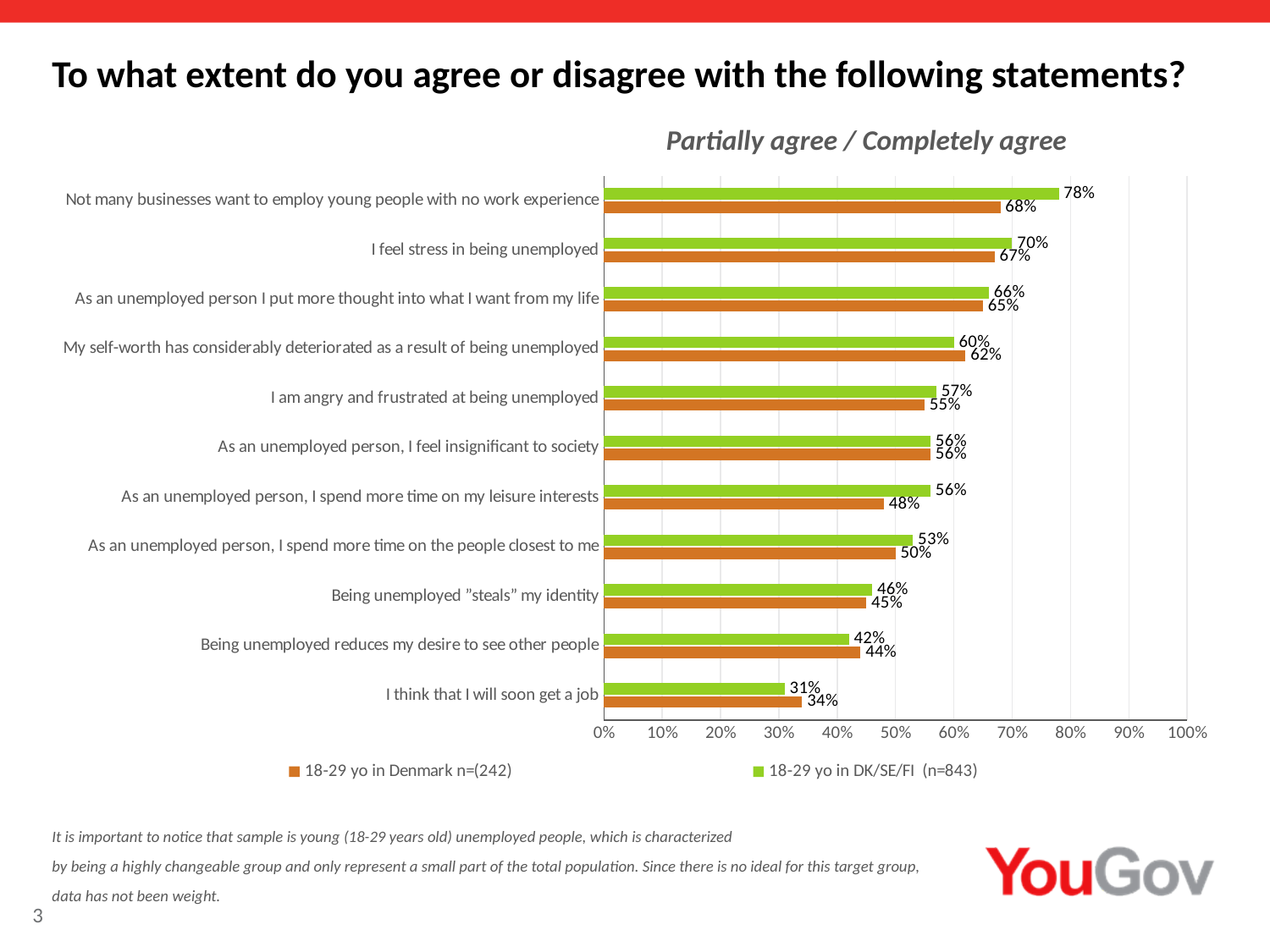
What is the value for 18-29 yo in DK/SE/FI (n=843) for "My self-worth has considerably deteriorated as a result of being unemployed"? 60% What is the value for 18-29 yo in Denmark n=(242) for "As an unemployed person, I spend more time on my leisure interests"? 48% Which statement has the highest value for 18-29 yo in Denmark n=(242)? Not many businesses want to employ young people with no work experience What is the value for 18-29 yo in DK/SE/FI (n=843) for "Not many businesses want to employ young people with no work experience"? 78% How many statements (categories) are plotted in the chart? 11 What is the subtitle shown above the chart? Partially agree / Completely agree What kind of chart is shown on the slide? Bar chart What is the difference between the 18-29 yo in DK/SE/FI (n=843) value and the 18-29 yo in Denmark n=(242) value for "Not many businesses want to employ young people with no work experience"? 10% Which statement has the lowest value for 18-29 yo in DK/SE/FI (n=843)? I think that I will soon get a job How many series does the legend list? 2 What is the value for 18-29 yo in Denmark n=(242) for "I feel stress in being unemployed"? 67% For "Being unemployed reduces my desire to see other people", which series has the larger value: 18-29 yo in Denmark n=(242) or 18-29 yo in DK/SE/FI (n=843)? 18-29 yo in Denmark n=(242)